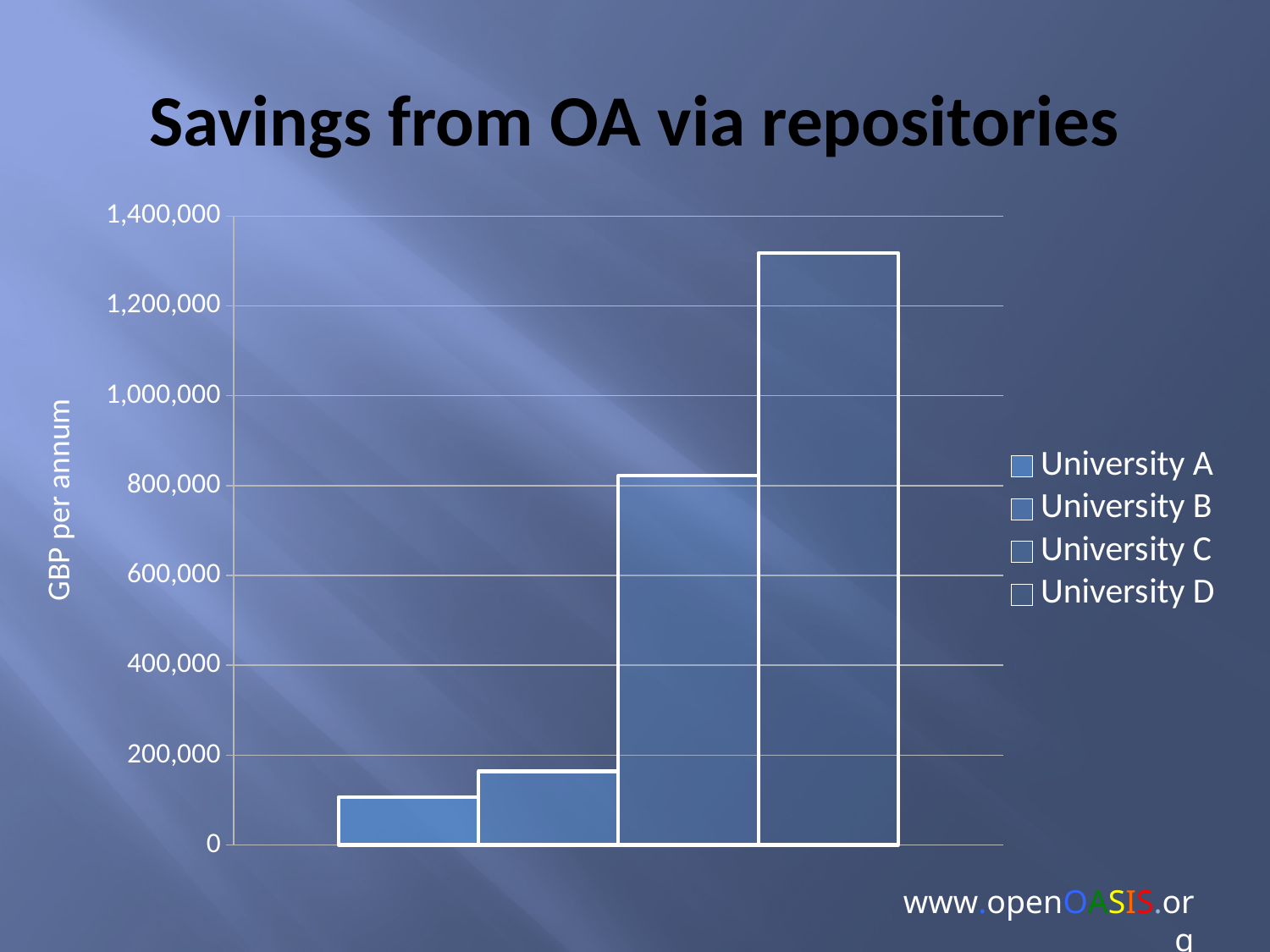
Which is larger, the value for University A or University D? University D Is the value for University A greater or less than 200,000? less What is the title of the chart? Savings from OA via repositories Do the bar values rise or fall from University A to University D? rise Which university has the highest savings? University D How many series does the legend list? 4 Is the value for University D greater or less than 1,200,000? greater What kind of chart is shown on the slide? bar chart Is the value for University C greater or less than 1,000,000? less Which is larger, the value for University C or University B? University C Which university has the lowest savings? University A What is the label on the vertical axis? GBP per annum